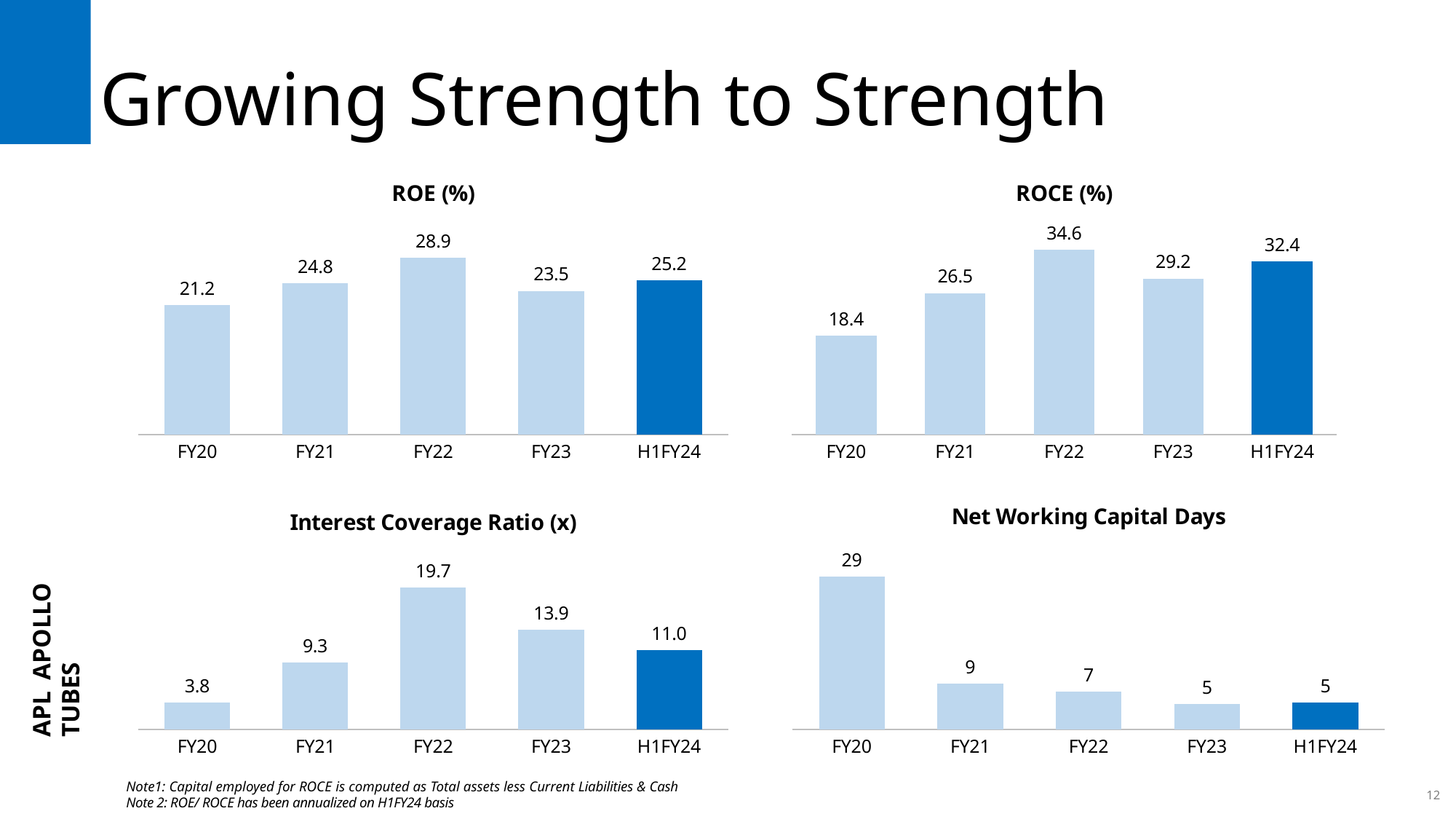
Which bar is shown in a darker blue in each of the four charts? H1FY24 In the ROCE (%) chart, which year has the lowest value? FY20 What type of chart is the ROCE (%) chart? bar chart In the ROE (%) chart, how many periods are shown on the x axis? 5 In the ROE (%) chart, what is the difference between FY21 and FY20? 3.6 In the Net Working Capital Days chart, is the value for FY21 larger or smaller than the value for FY22? larger In the ROE (%) chart, what is the value for FY22? 28.9 In the Net Working Capital Days chart, what is the value for FY20? 29 In the Net Working Capital Days chart, do the values generally rise or fall from FY20 to H1FY24? fall In the Interest Coverage Ratio (x) chart, which period has the highest value? FY22 In the Interest Coverage Ratio (x) chart, what is the difference between FY22 and FY23? 5.8 In the ROCE (%) chart, what is the value for H1FY24? 32.4